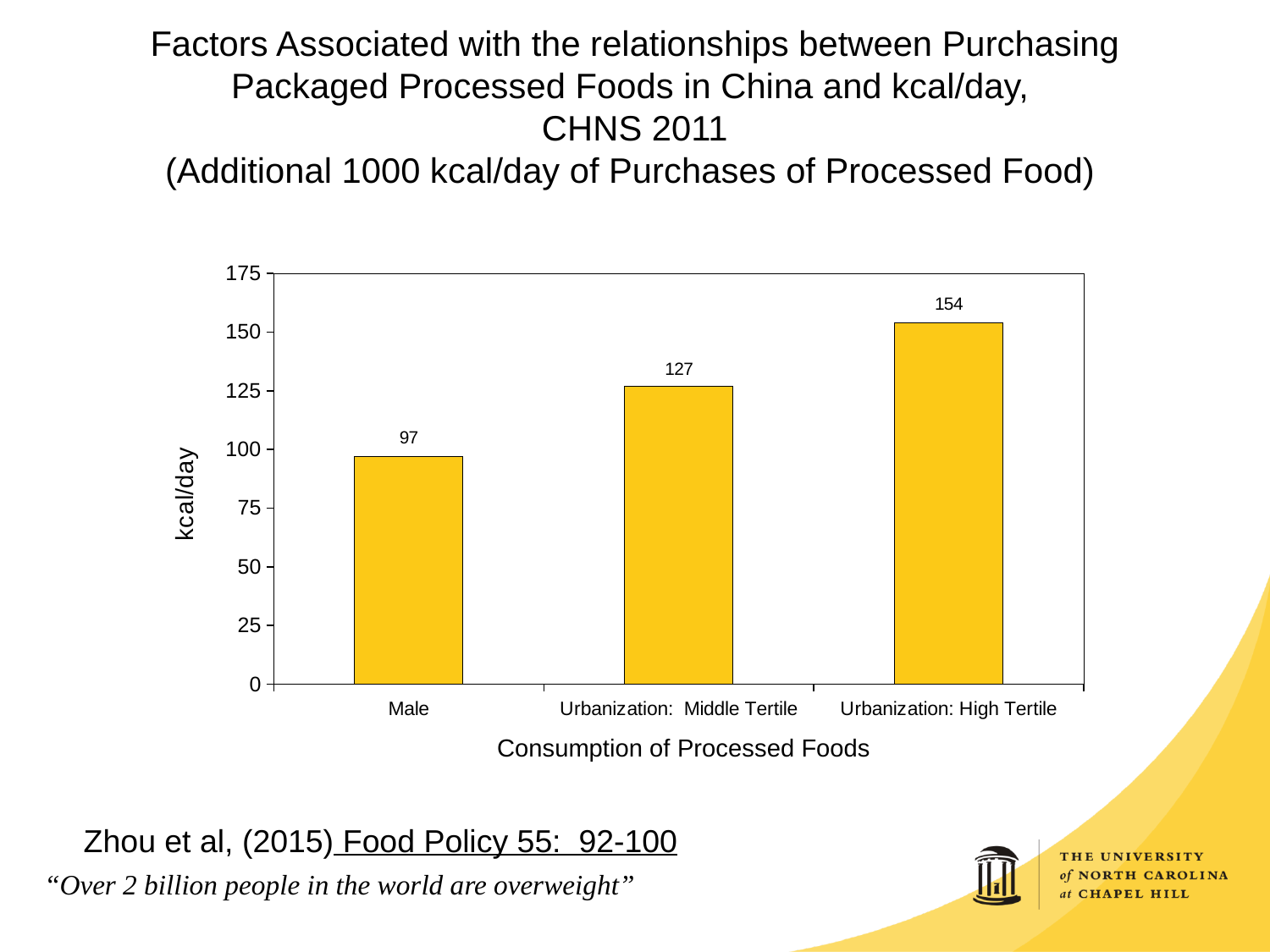
Which category has the lowest value? Male What is the value for Urbanization: High Tertile? 154 What is the value for Urbanization: Middle Tertile? 127 Is the value for Urbanization: High Tertile greater or less than 150? greater Which category has the highest value? Urbanization: High Tertile What is the label of the y axis? kcal/day What kind of chart is shown on the slide? bar chart What is the difference between the values for Urbanization: High Tertile and Male? 57 What is the value for Male? 97 How many categories are shown on the x axis? 3 Which is larger, the value for Male or the value for Urbanization: Middle Tertile? Urbanization: Middle Tertile What is the difference between the values for Urbanization: Middle Tertile and Male? 30